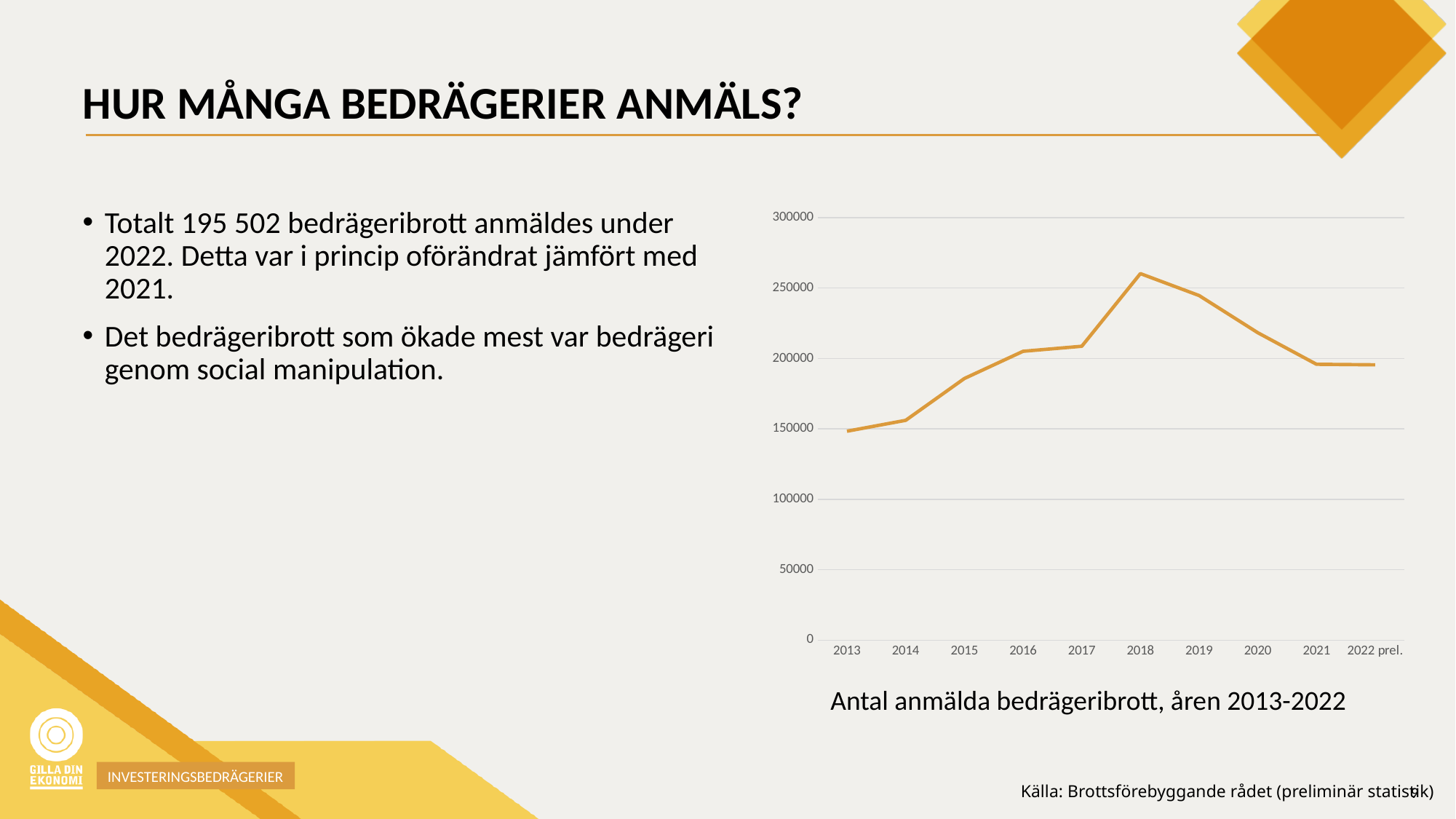
In which year does the line reach its highest value? 2018 Which year has the larger value, 2018 or 2021? 2018 In which year does the line have its lowest value? 2013 Is the value for 2018 greater or less than 250000? greater How many years are plotted on the x axis of the chart? 10 Do the values rise or fall from 2018 to 2021? fall Is the value for 2021 greater or less than 200000? less What is the title of the chart? Antal anmälda bedrägeribrott, åren 2013-2022 What kind of chart is shown on the slide? line chart Is the value for 2016 greater or less than 200000? greater Do the values rise or fall from 2013 to 2018? rise